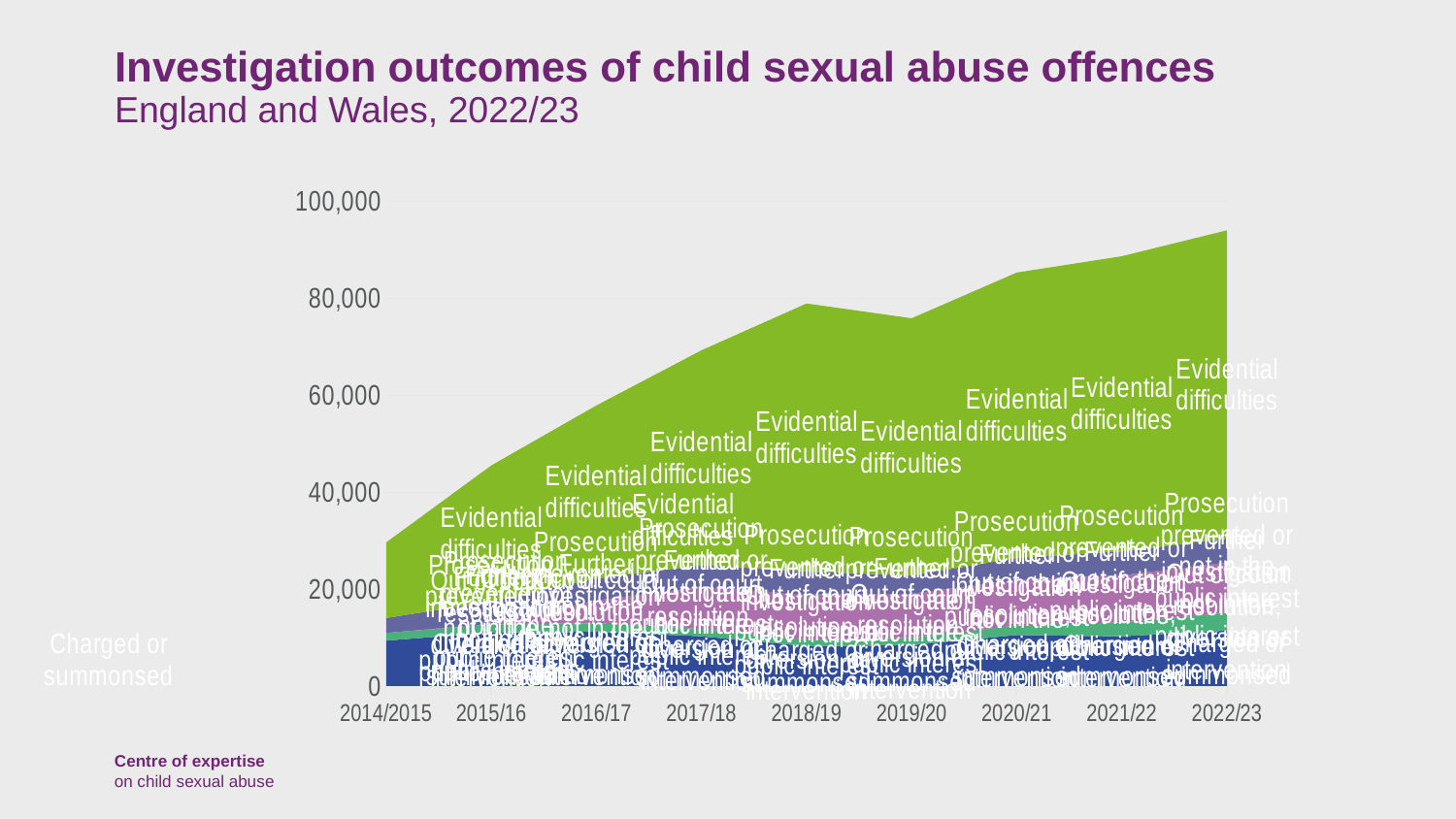
Which year has the lowest total number of investigation outcomes? 2014/2015 Is the total number of outcomes larger in 2022/23 or in 2014/2015? 2022/23 Which outcome category occupies the largest area of the chart? Evidential difficulties Do the total investigation outcomes generally rise or fall from 2014/2015 to 2022/23? Rise Is the total number of outcomes in 2014/2015 greater or less than 40,000? less Is the total number of outcomes in 2022/23 greater or less than 80,000? greater How many years are shown along the x axis of the chart? 9 What is the title of the chart on the slide? Investigation outcomes of child sexual abuse offences What kind of chart is shown on the slide? Stacked area chart Which year has the highest total number of investigation outcomes? 2022/23 Is the total number of outcomes in 2017/18 greater or less than 60,000? greater